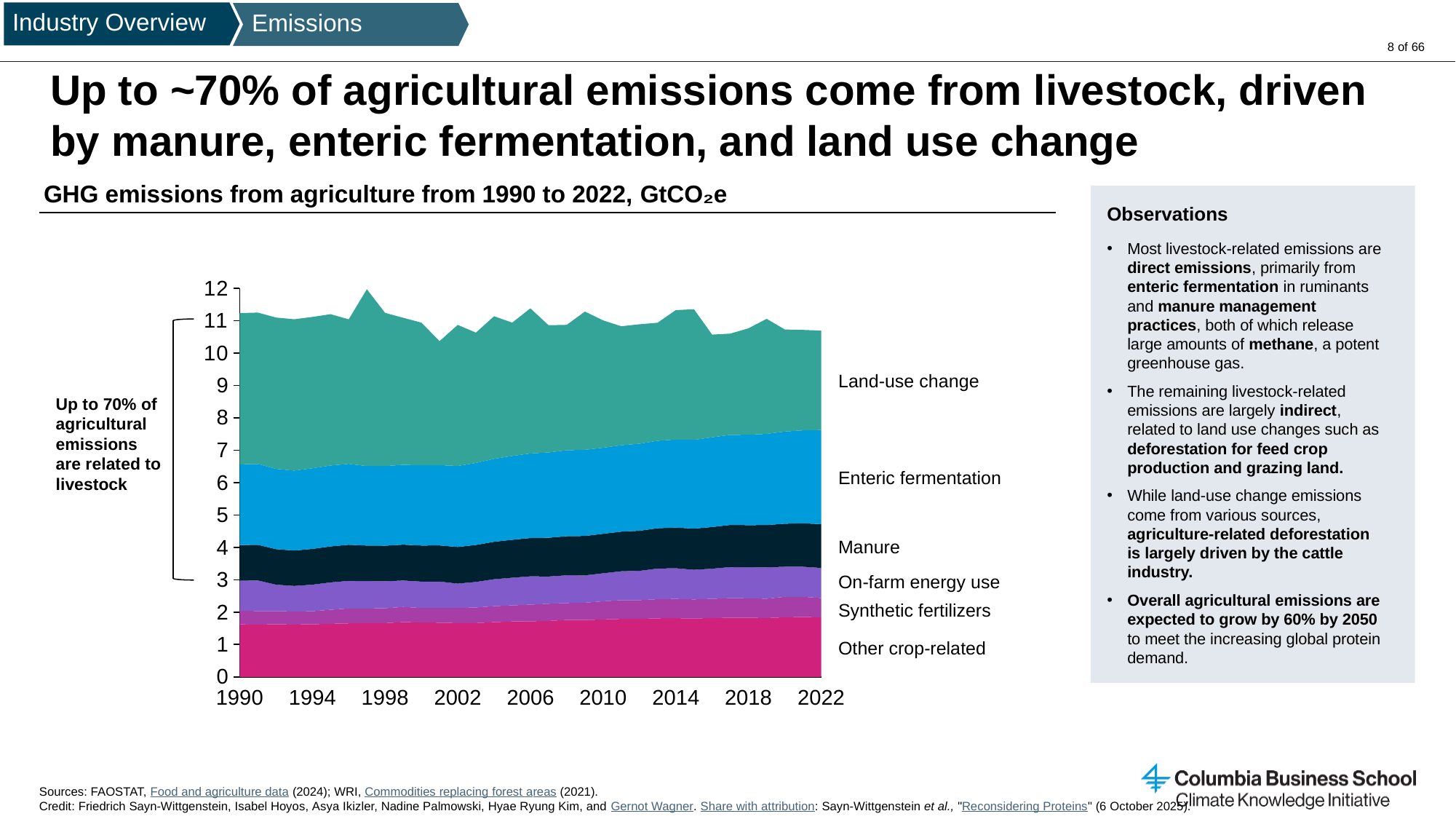
In 2022, which is larger: the Enteric fermentation band or the On-farm energy use band? Enteric fermentation Is the total value for 2022 greater or less than 12? less What kind of chart is shown on the slide? Stacked area chart Is the total value for 2022 greater or less than 10? greater Is the total value for 1990 greater or less than 12? less What is the title of the chart? GHG emissions from agriculture from 1990 to 2022, GtCO₂e How many series are labelled on the chart? 6 Which series has the thinnest band in 2022? Synthetic fertilizers In 2022, which is larger: the Land-use change band or the Synthetic fertilizers band? Land-use change Which series is plotted at the bottom of the stack? Other crop-related Does the upper boundary of the Enteric fermentation band rise or fall from 1990 to 2022? rise How many year labels are shown on the x axis? 9